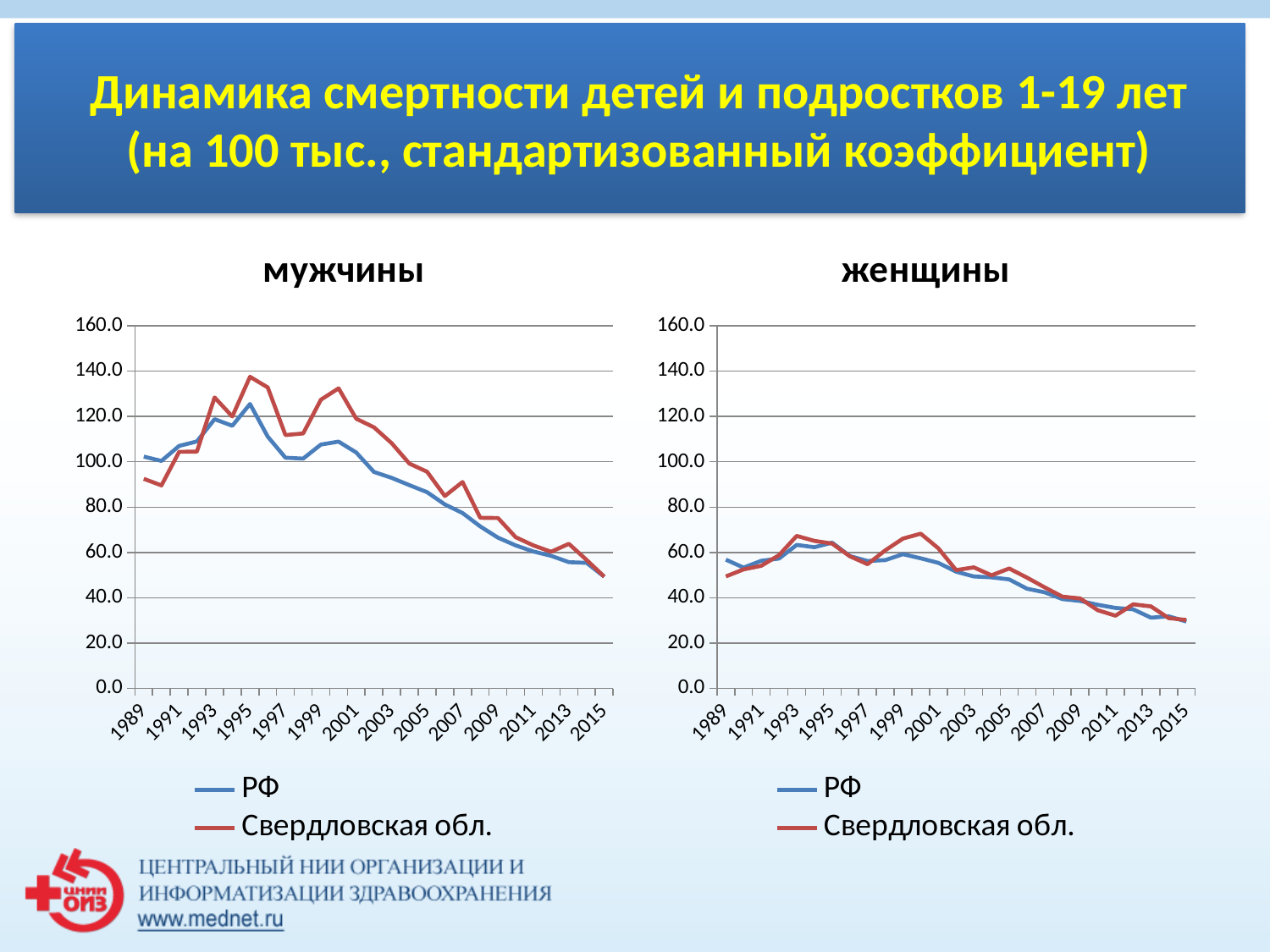
In the "мужчины" chart, which series has the higher value in 1995, РФ or Свердловская обл.? Свердловская обл. In the "женщины" chart, which colour is used for the РФ series? blue How many series does the legend of the "женщины" chart list? 2 In the "женщины" chart, is the value for РФ in 2015 greater or less than 40? less In the "мужчины" chart, in which year does the Свердловская обл. series reach its highest value? 1995 In the "мужчины" chart, is the value for Свердловская обл. in 1995 greater or less than 120? greater In the "женщины" chart, is the value for Свердловская обл. in 2000 greater or less than 60? greater In the "женщины" chart, which series has the higher value in 2000, РФ or Свердловская обл.? Свердловская обл. What kind of chart is the "мужчины" chart? line chart In the "женщины" chart, in which year does the Свердловская обл. series reach its highest value? 2000 In the "мужчины" chart, do the values for РФ rise or fall from 2000 to 2015? fall